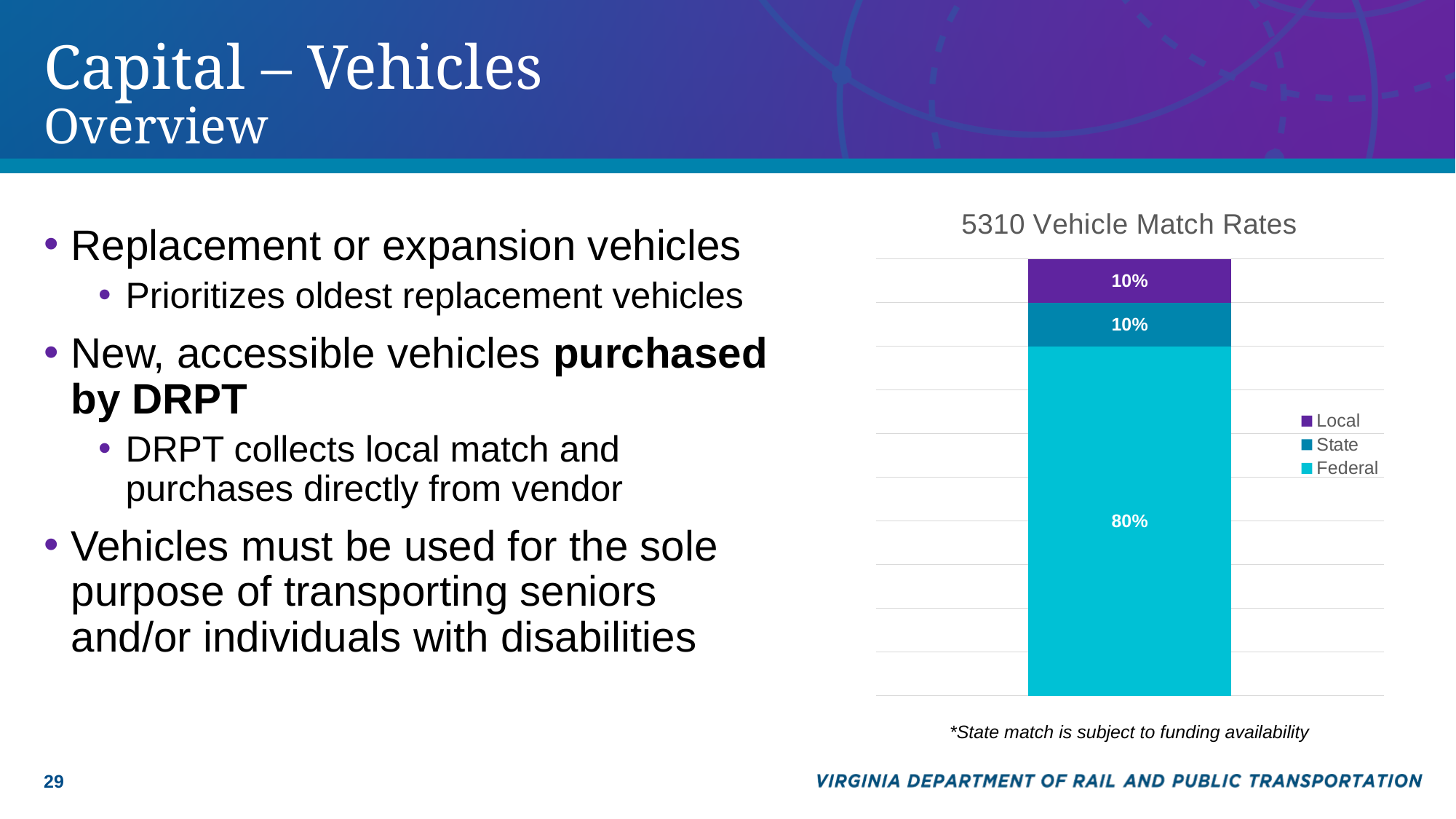
What is the Local share shown in the chart? 10% What is the State share shown in the chart? 10% What is the difference between the Federal share and the Local share? 70% What is the total of the stacked bar? 100% How many series does the chart legend list? 3 Which series has the largest share in the chart? Federal What kind of chart is shown on the slide? Stacked bar chart Which series is shown in purple in the chart? Local What is the Federal share shown in the chart? 80% What is the title of the chart? 5310 Vehicle Match Rates How many bars are plotted in the chart? 1 Which is larger, the Federal share or the State share? Federal